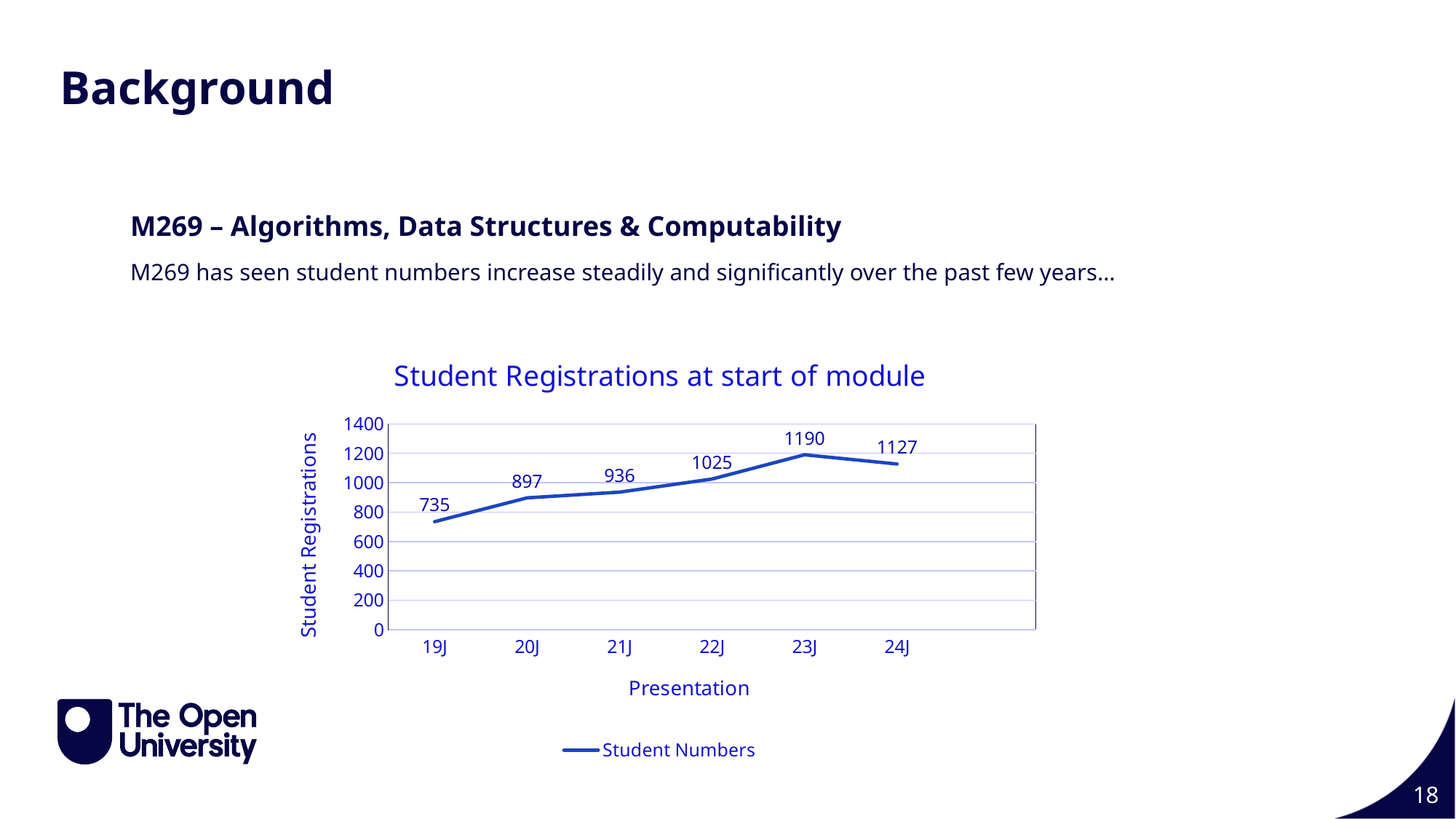
What is the difference between the values for 20J and 19J? 162 What is the value for 24J? 1127 Which presentation has the highest student registrations? 23J What kind of chart is this? line chart Which presentation has the lowest student registrations? 19J What is the value for 22J? 1025 Which is larger, the value for 21J or the value for 22J? 22J What is the value for 19J? 735 How many presentations are shown on the x axis? 6 Is the value for 20J greater or less than 1000? less What is the title of the chart? Student Registrations at start of module What is the difference between the values for 23J and 24J? 63